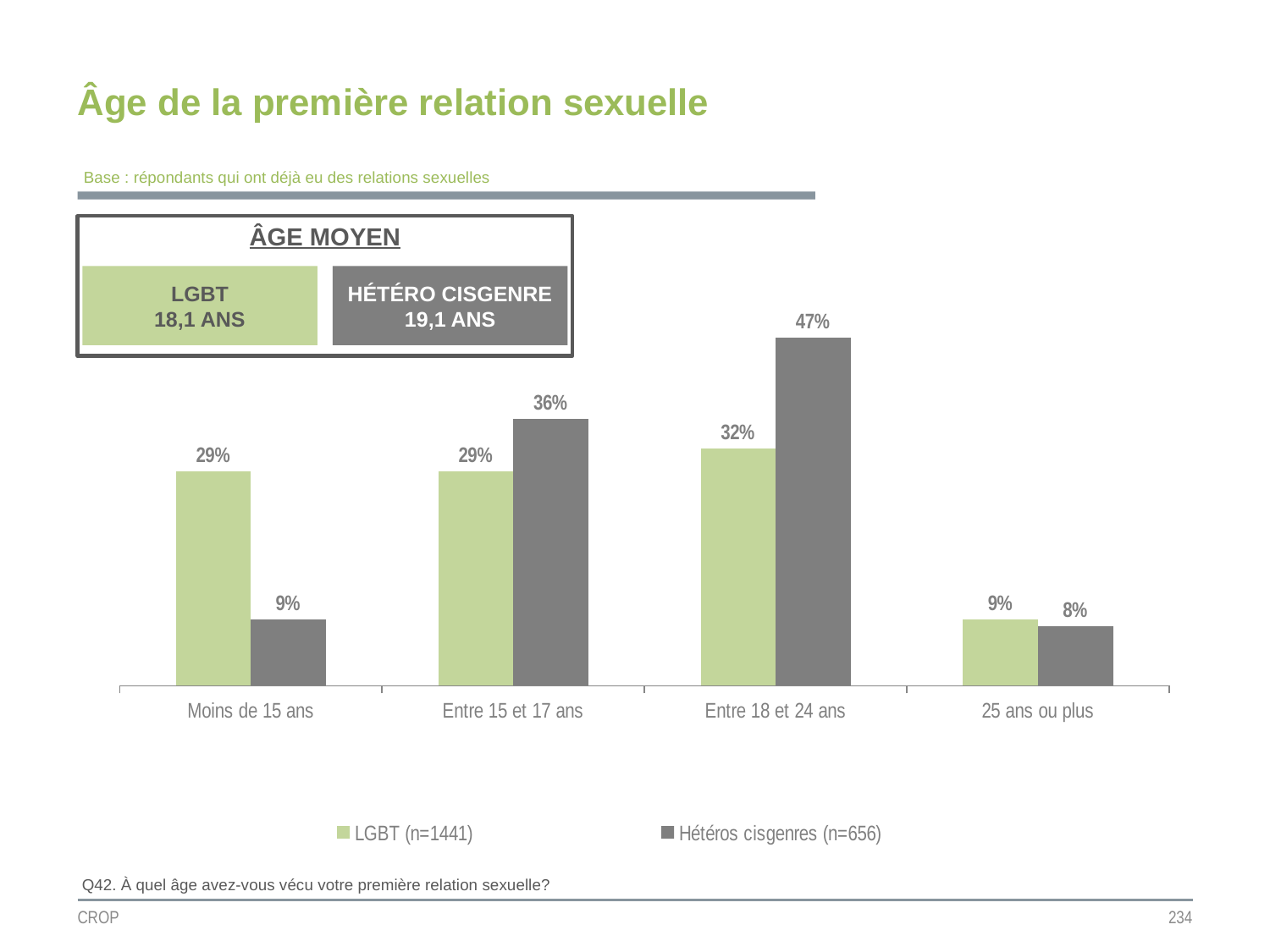
Which category has the lowest value for LGBT (n=1441)? 25 ans ou plus What is the value for LGBT (n=1441) in the 'Moins de 15 ans' category? 29% In the 'Moins de 15 ans' category, which series has the larger value, LGBT (n=1441) or Hétéros cisgenres (n=656)? LGBT (n=1441) What kind of chart is shown on the slide? Bar chart Which category has the highest value for Hétéros cisgenres (n=656)? Entre 18 et 24 ans What is the value for LGBT (n=1441) in the 'Entre 15 et 17 ans' category? 29% What is the value for Hétéros cisgenres (n=656) in the 'Moins de 15 ans' category? 9% What is the average age (âge moyen) shown for LGBT respondents? 18,1 ANS What is the value for Hétéros cisgenres (n=656) in the 'Entre 18 et 24 ans' category? 47% How many series does the legend list? 2 How many categories are shown on the x axis? 4 What is the difference between the Hétéros cisgenres (n=656) and LGBT (n=1441) values in the 'Entre 18 et 24 ans' category? 15%